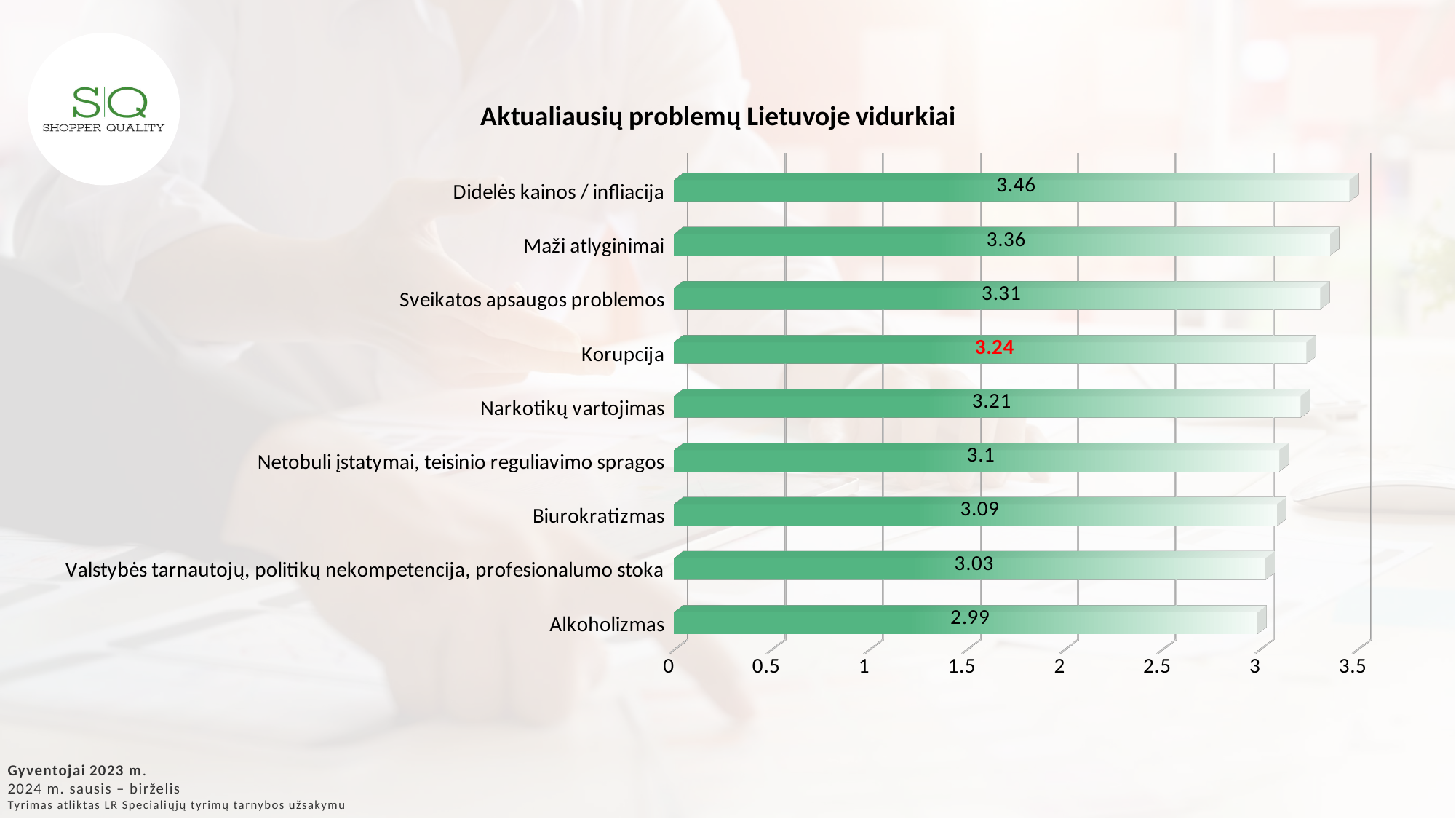
What is the difference between the values for Korupcija and Alkoholizmas? 0.25 What is the value for Alkoholizmas? 2.99 What is the difference between the values for Didelės kainos / infliacija and Maži atlyginimai? 0.1 What is the value for Netobuli įstatymai, teisinio reguliavimo spragos? 3.1 Is the value for Alkoholizmas greater or less than 3? less Which is larger, the value for Sveikatos apsaugos problemos or the value for Biurokratizmas? Sveikatos apsaugos problemos What is the title of the chart? Aktualiausių problemų Lietuvoje vidurkiai Which category has the highest value? Didelės kainos / infliacija How many categories are shown in the chart? 9 What is the value for Korupcija? 3.24 What kind of chart is shown on the slide? bar chart Which category has the lowest value? Alkoholizmas